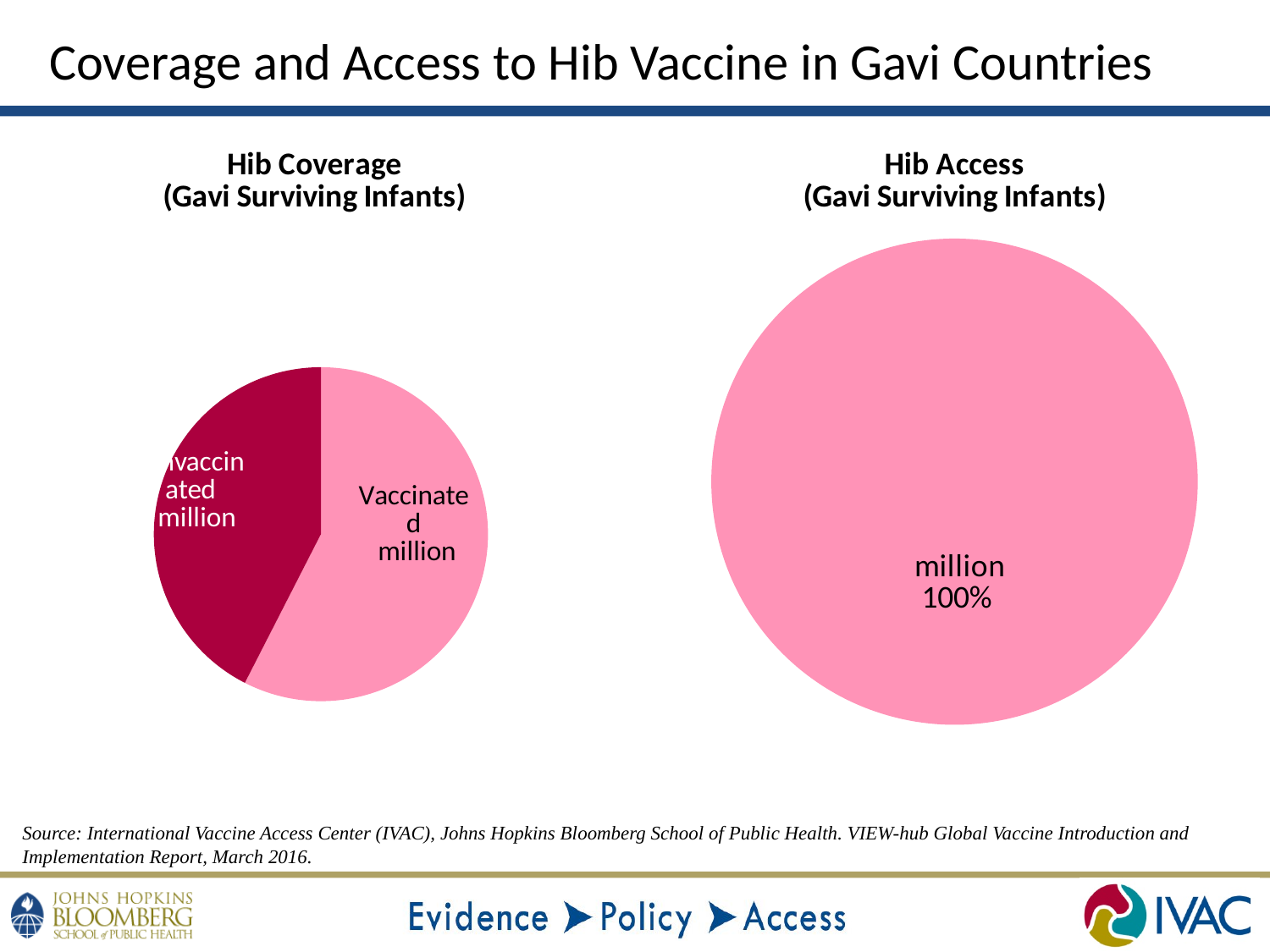
How many pie charts are shown on the slide? 2 In the Hib Coverage (Gavi Surviving Infants) chart, which slice is larger, Vaccinated or Unvaccinated? Vaccinated What is the title of the pie chart on the left of the slide? Hib Coverage (Gavi Surviving Infants) In the Hib Access (Gavi Surviving Infants) chart, what share of the pie does the single slice represent? 100% What is the title of the pie chart on the right of the slide? Hib Access (Gavi Surviving Infants) How many slices does the Hib Coverage (Gavi Surviving Infants) pie chart have? 2 In the Hib Coverage (Gavi Surviving Infants) chart, is the Vaccinated slice more or less than half of the pie? More How many slices does the Hib Access (Gavi Surviving Infants) pie chart have? 1 What kind of chart is the Hib Access (Gavi Surviving Infants) chart? Pie chart What kind of chart is the Hib Coverage (Gavi Surviving Infants) chart? Pie chart